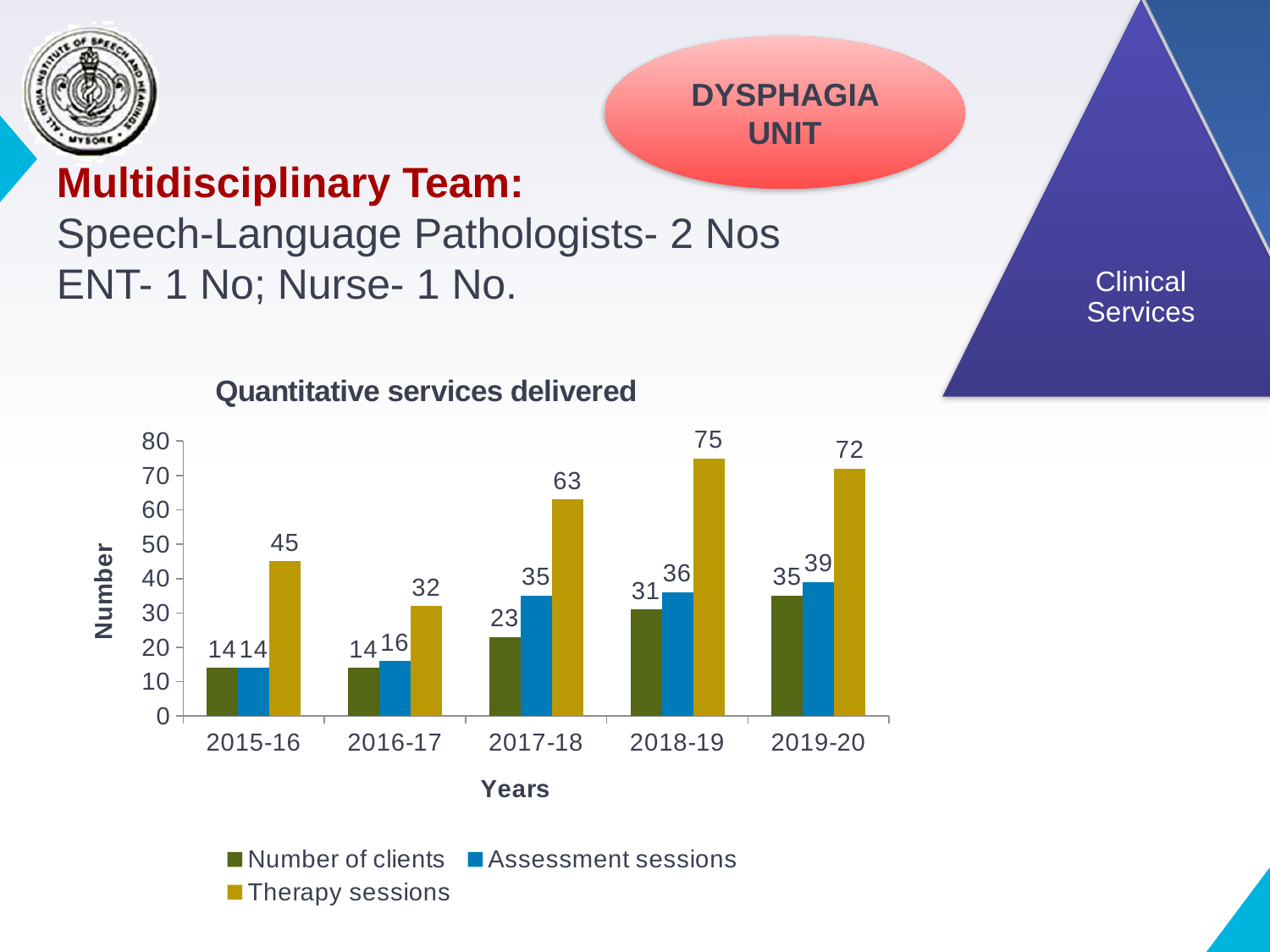
What is the value for Assessment sessions in 2019-20? 39 Which is larger in 2019-20: Number of clients or Assessment sessions? Assessment sessions How many years are shown on the x axis? 5 What is the difference between Therapy sessions and Assessment sessions in 2017-18? 28 What is the title of the chart? Quantitative services delivered What kind of chart is shown? Bar chart Which year has the highest value for Therapy sessions? 2018-19 What is the value for Therapy sessions in 2018-19? 75 What is the value for Number of clients in 2017-18? 23 Do the values for Number of clients rise or fall from 2016-17 to 2019-20? Rise How many series does the legend list? 3 Which year has the lowest value for Number of clients? 2015-16 and 2016-17